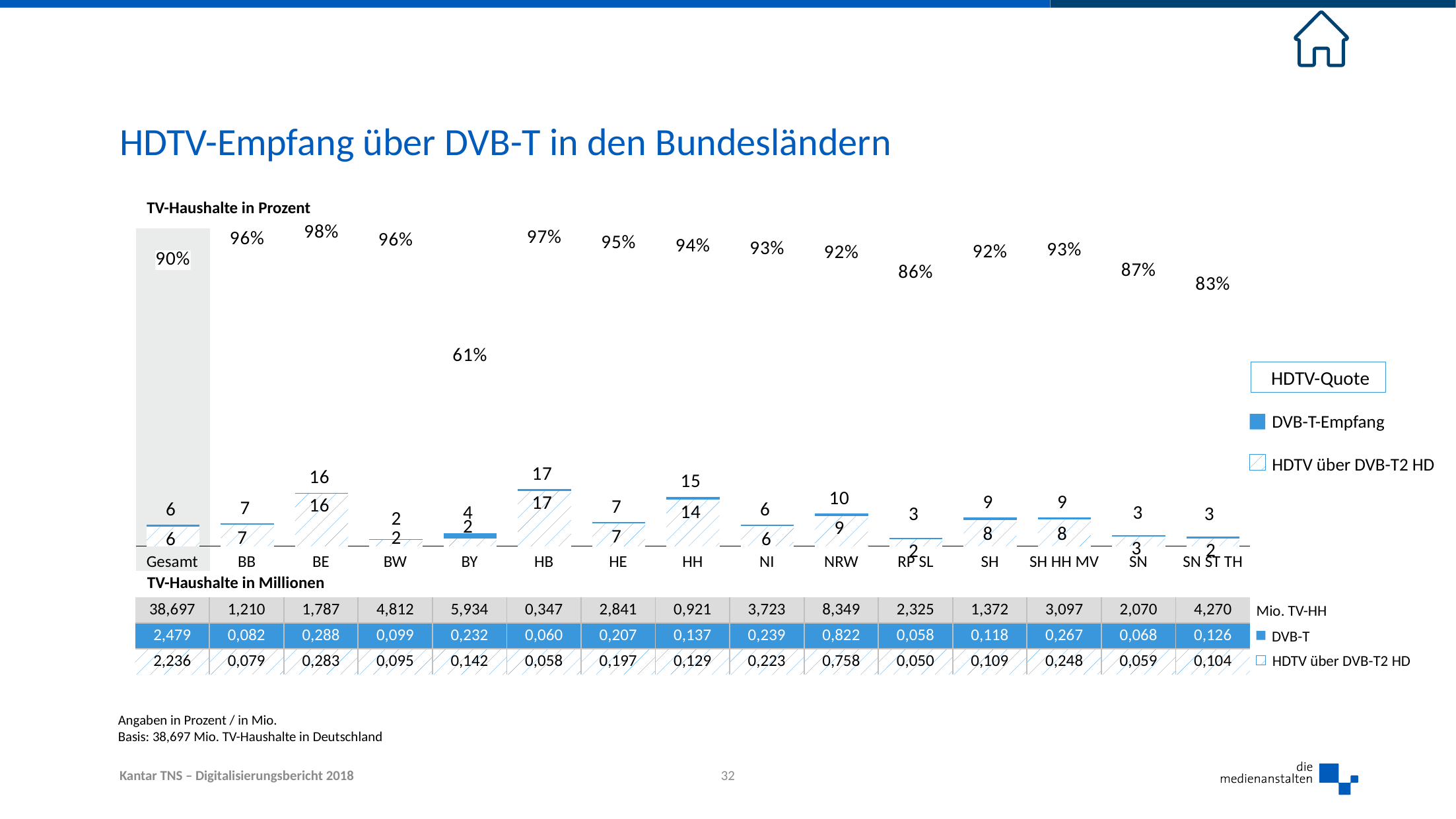
What is the HDTV über DVB-T2 HD value (in percent) for HH? 14 Which has the higher DVB-T-Empfang value, BE or HH? BE What is the HDTV-Quote shown for BY? 61% What kind of chart is used to show DVB-T-Empfang and HDTV über DVB-T2 HD? Bar chart For BY, what is the difference between the DVB-T-Empfang value and the HDTV über DVB-T2 HD value (in percent)? 2 What is the DVB-T-Empfang value (in percent) for HB? 17 In the table of TV-Haushalte in Millionen, what is the Mio. TV-HH value for Gesamt? 38,697 In the table of TV-Haushalte in Millionen, what is the DVB-T value for NRW? 0,822 Which Bundesland has the highest HDTV-Quote? BE Which category has the lowest HDTV-Quote? SN ST TH How many categories are shown along the x axis of the chart? 15 How many series does the legend list? 3